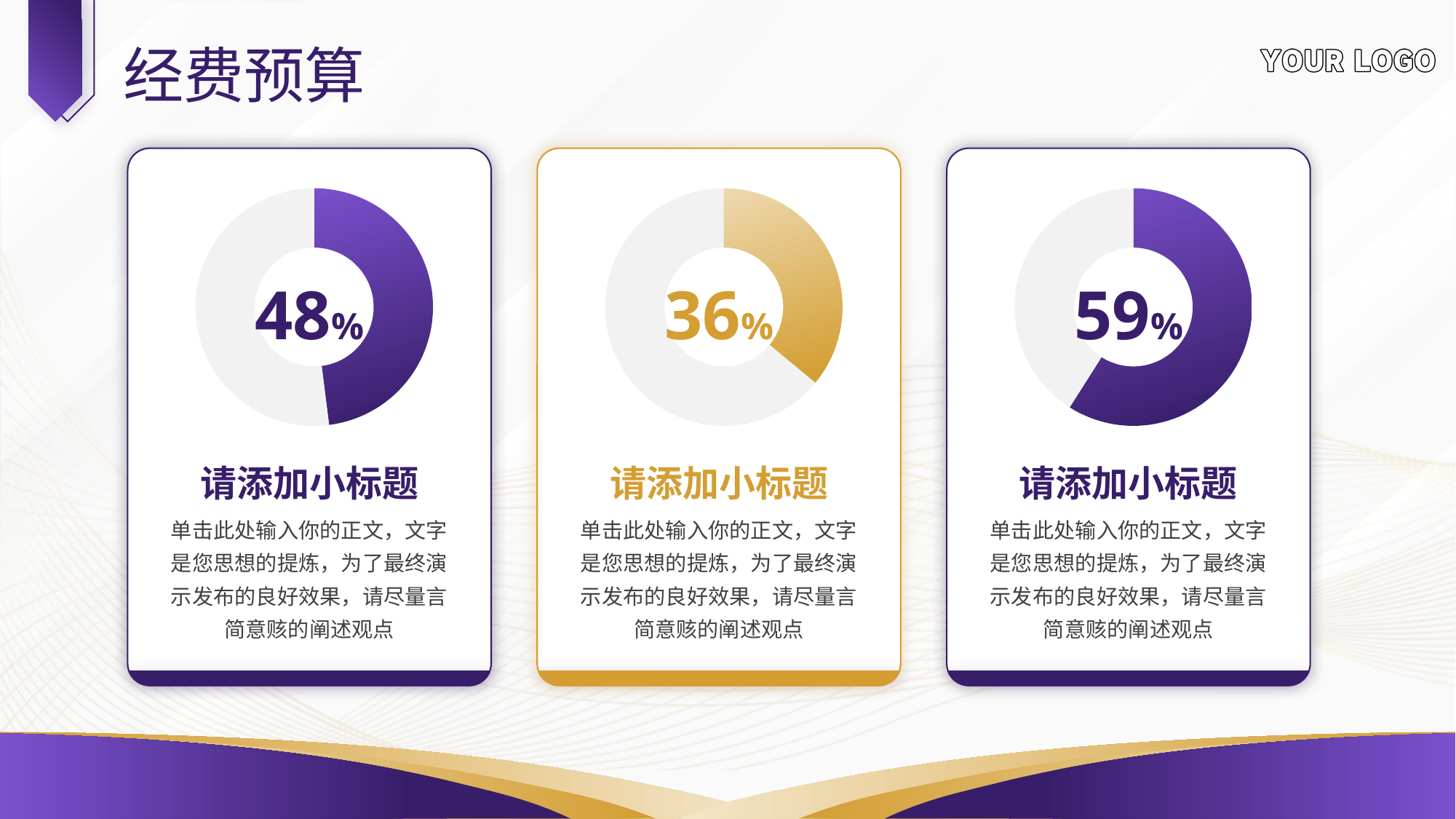
What percentage is shown in the left donut chart? 48% Which of the three donut charts shows the lowest percentage: left, middle or right? middle Which is larger, the percentage in the left donut chart or the percentage in the right donut chart? right What colour is the filled portion of the middle donut chart? gold Which of the three donut charts shows the highest percentage: left, middle or right? right What percentage is shown in the right donut chart? 59% What is the title of the slide? 经费预算 What kind of chart is used in each of the three cards on the slide? donut chart How many donut charts are on the slide? 3 What percentage is shown in the middle donut chart? 36% What is the difference between the percentage in the left donut chart and the percentage in the middle donut chart? 12% What is the difference between the percentage in the right donut chart and the percentage in the middle donut chart? 23%